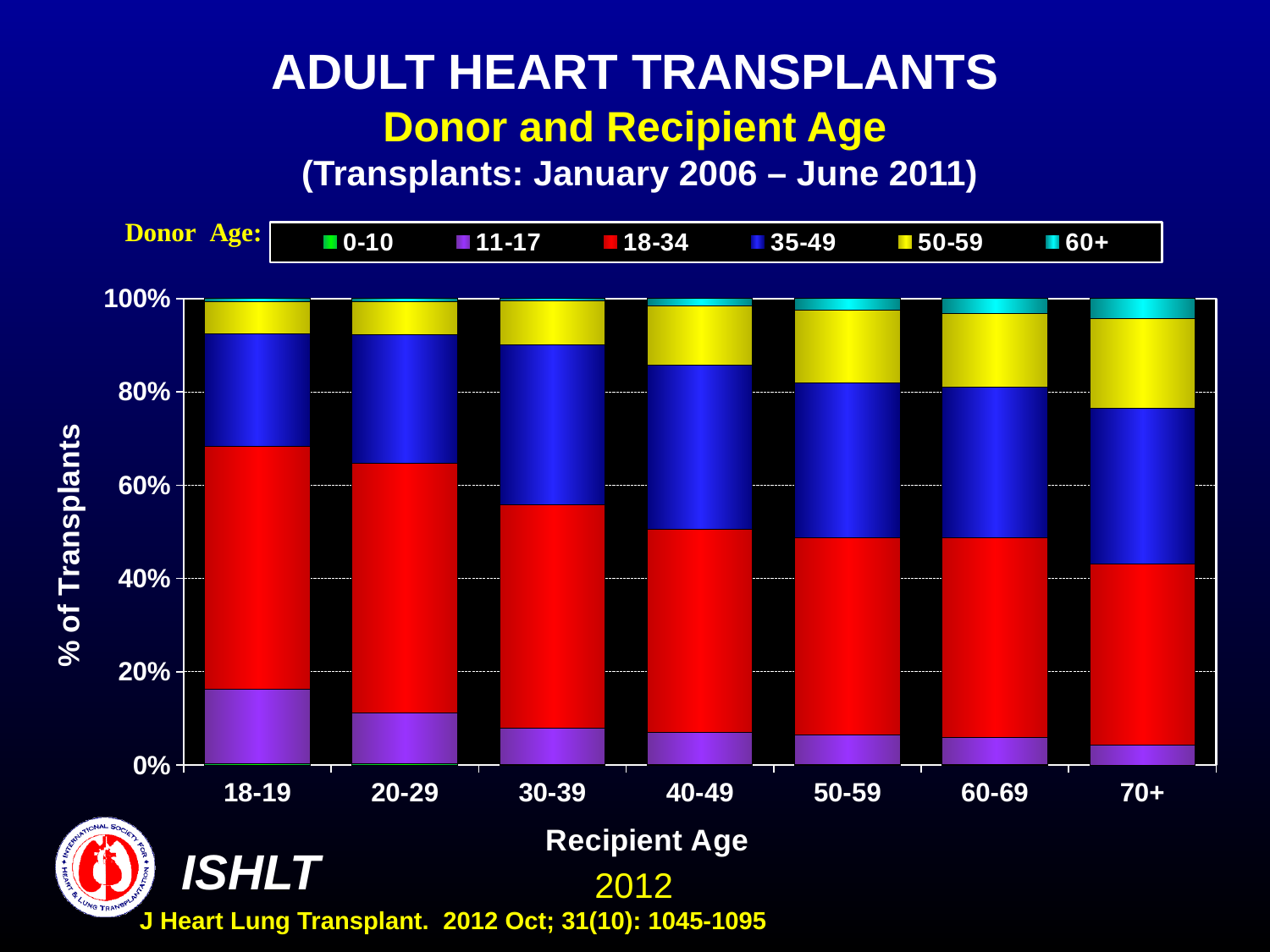
Does the share of 11-17 donors rise or fall as recipient age increases along the x axis? fall How many donor age groups does the legend list? 6 Is the share of 11-17 donors for recipient age 18-19 greater or less than 20%? less What kind of chart is shown on the slide? Stacked bar chart What is the label of the y axis? % of Transplants Which recipient age group has the largest share of 60+ donors? 70+ Is the share of 11-17 donors for recipient age 70+ greater or less than 10%? less Is the share of 11-17 donors larger for recipient age 18-19 or for recipient age 70+? 18-19 Which recipient age group has the smallest share of 11-17 donors? 70+ How many recipient age groups are shown along the x axis? 7 What is the label of the x axis? Recipient Age Which recipient age group has the largest share of 11-17 donors? 18-19